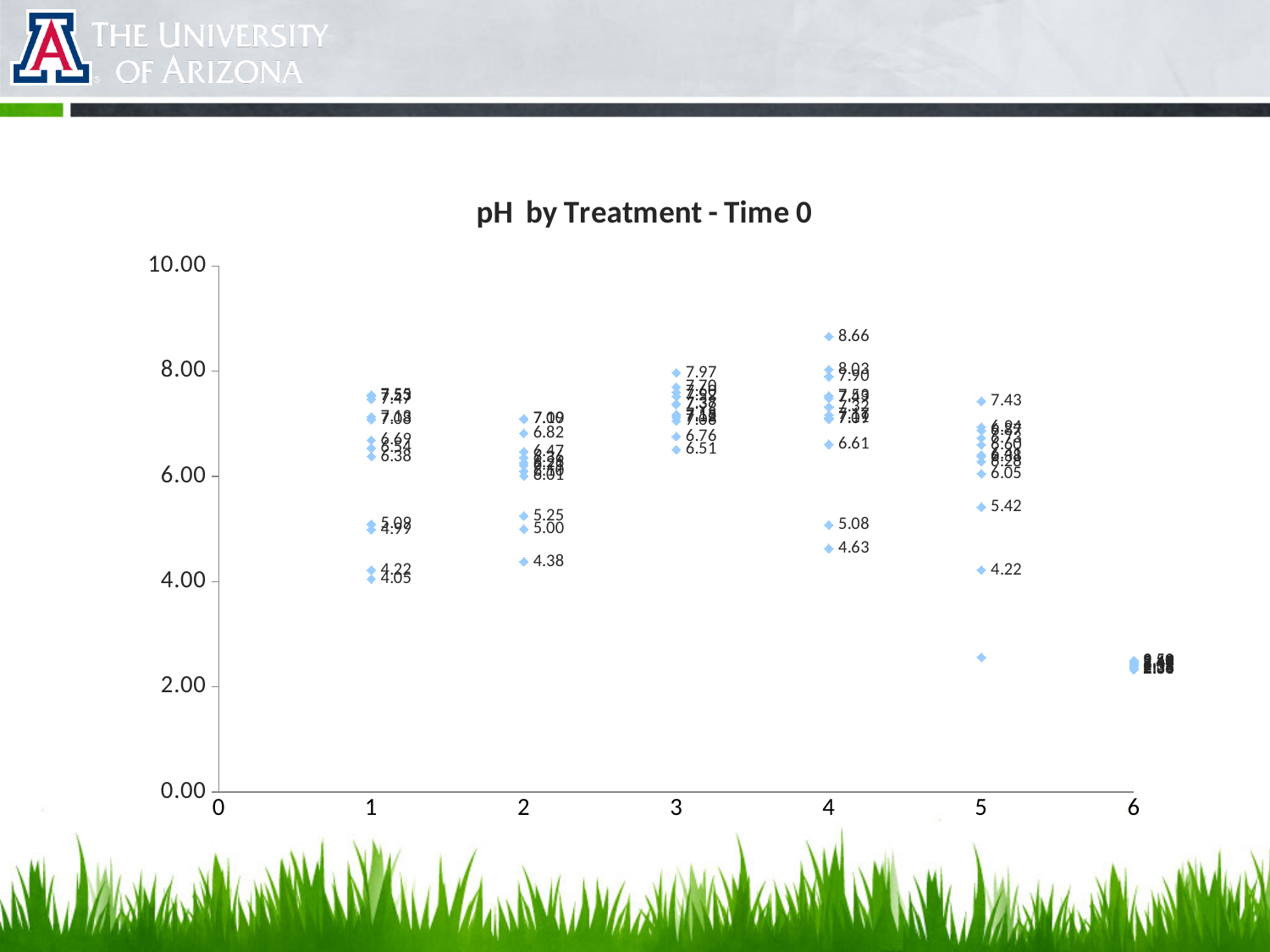
What is the difference between the highest (8.66) and the lowest (4.63) pH values plotted for treatment 4? 4.03 What kind of chart is shown on the slide? scatter chart Which is larger: the highest pH value for treatment 3 or the highest pH value for treatment 4? treatment 4 What is the lowest pH value plotted for treatment 2? 4.38 What is the highest pH value plotted for treatment 3? 7.97 What is the lowest pH value plotted for treatment 3? 6.51 Which treatment (x-axis value) has the highest pH point on the chart? 4 What is the maximum value shown on the y axis? 10.00 What is the highest pH value plotted on the chart? 8.66 Are the pH values plotted for treatment 6 greater or less than 4.00? less What is the lowest pH value plotted for treatment 1? 4.05 What is the title of the chart? pH by Treatment - Time 0